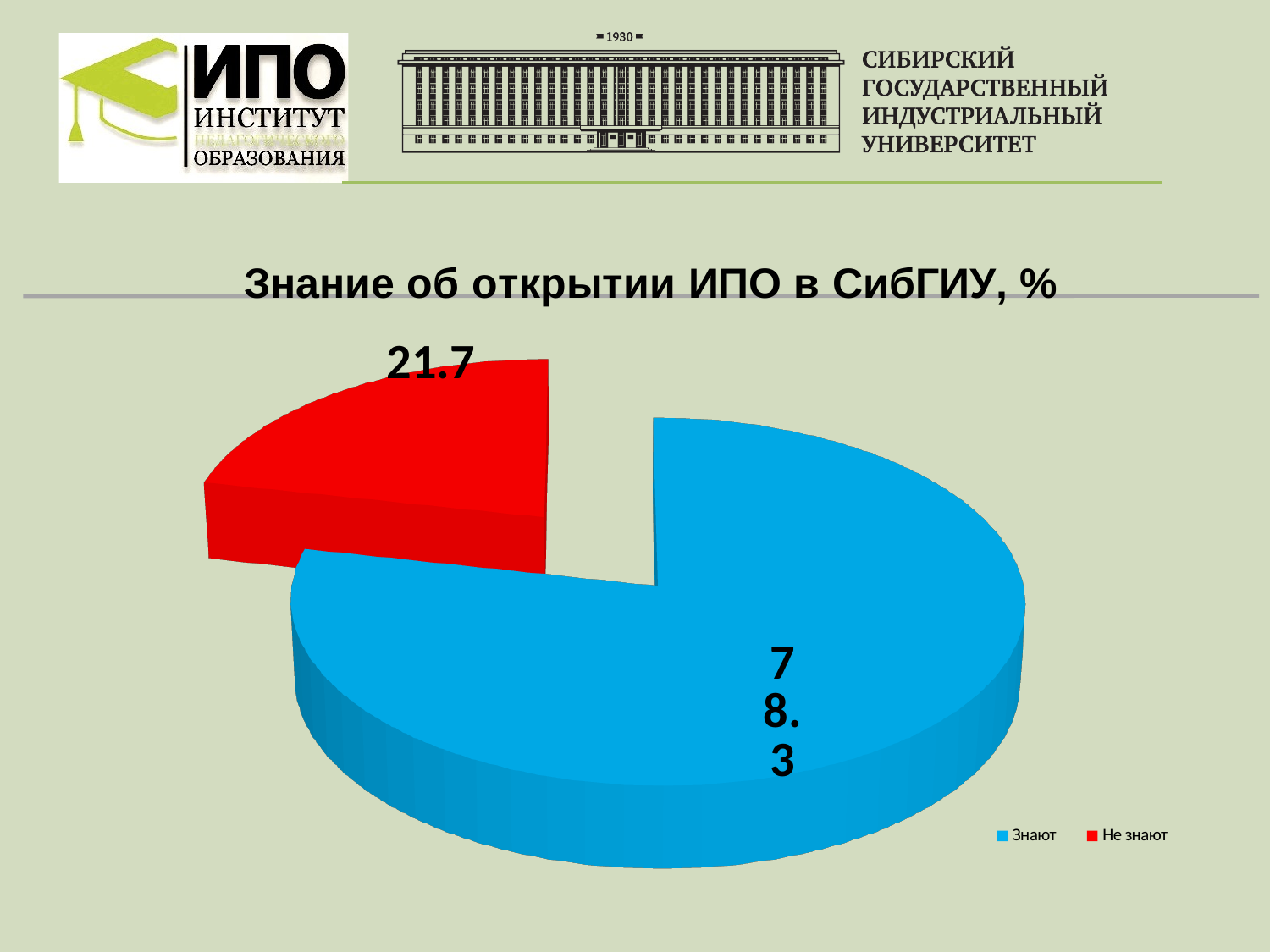
How many entries does the legend list? 2 What share of the pie does the Знают slice represent? 78.3% Which category has the largest slice of the pie? Знают Which is larger, the value for Знают or the value for Не знают? Знают What is the value for Знают? 78.3 What type of chart is shown on the slide? pie chart Which category has the smallest slice of the pie? Не знают What colour is the slice for Не знают? red What is the difference between the values for Знают and Не знают? 56.6 What is the value for Не знают? 21.7 How many slices does the pie chart have? 2 What is the title of the chart? Знание об открытии ИПО в СибГИУ, %